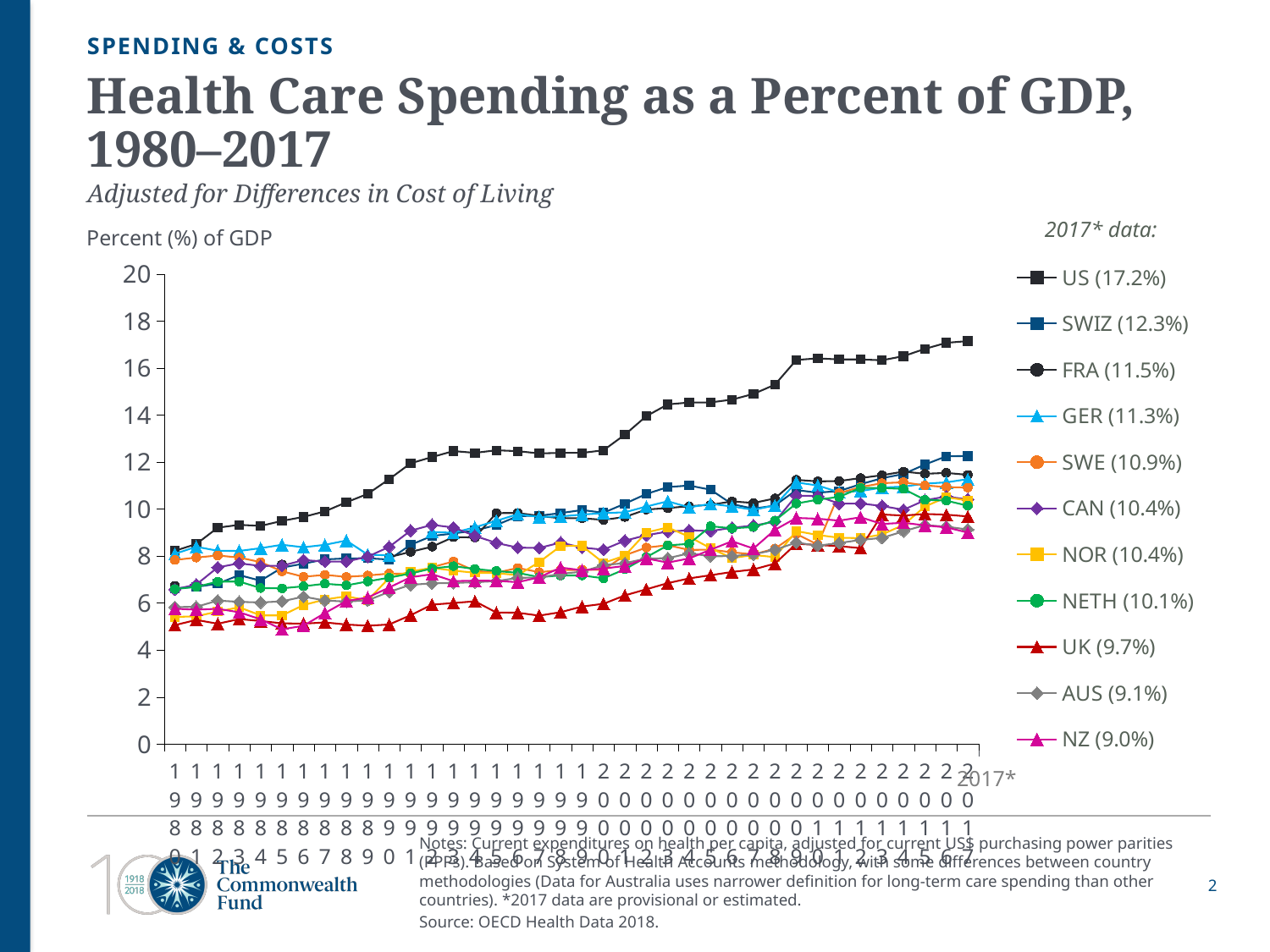
Which country had the lowest health care spending as a percent of GDP in 2017? NZ According to the legend, what was health care spending as a percent of GDP for the US in 2017? 17.2% According to the legend, what was the UK's 2017 health care spending as a percent of GDP? 9.7% What is the title of the chart? Health Care Spending as a Percent of GDP, 1980–2017 How many countries (series) does the legend list? 11 Which country had the highest health care spending as a percent of GDP in 2017? US Is the US value in 1980 greater or less than 10? less Is the UK value in 1980 greater or less than 6? less What kind of chart is shown on the slide? line chart By how many percentage points did the US 2017 value exceed the SWIZ 2017 value? 4.9 percentage points Does the US line generally rise or fall from 1980 to 2017? rise Which had the higher 2017 value, FRA or GER? FRA